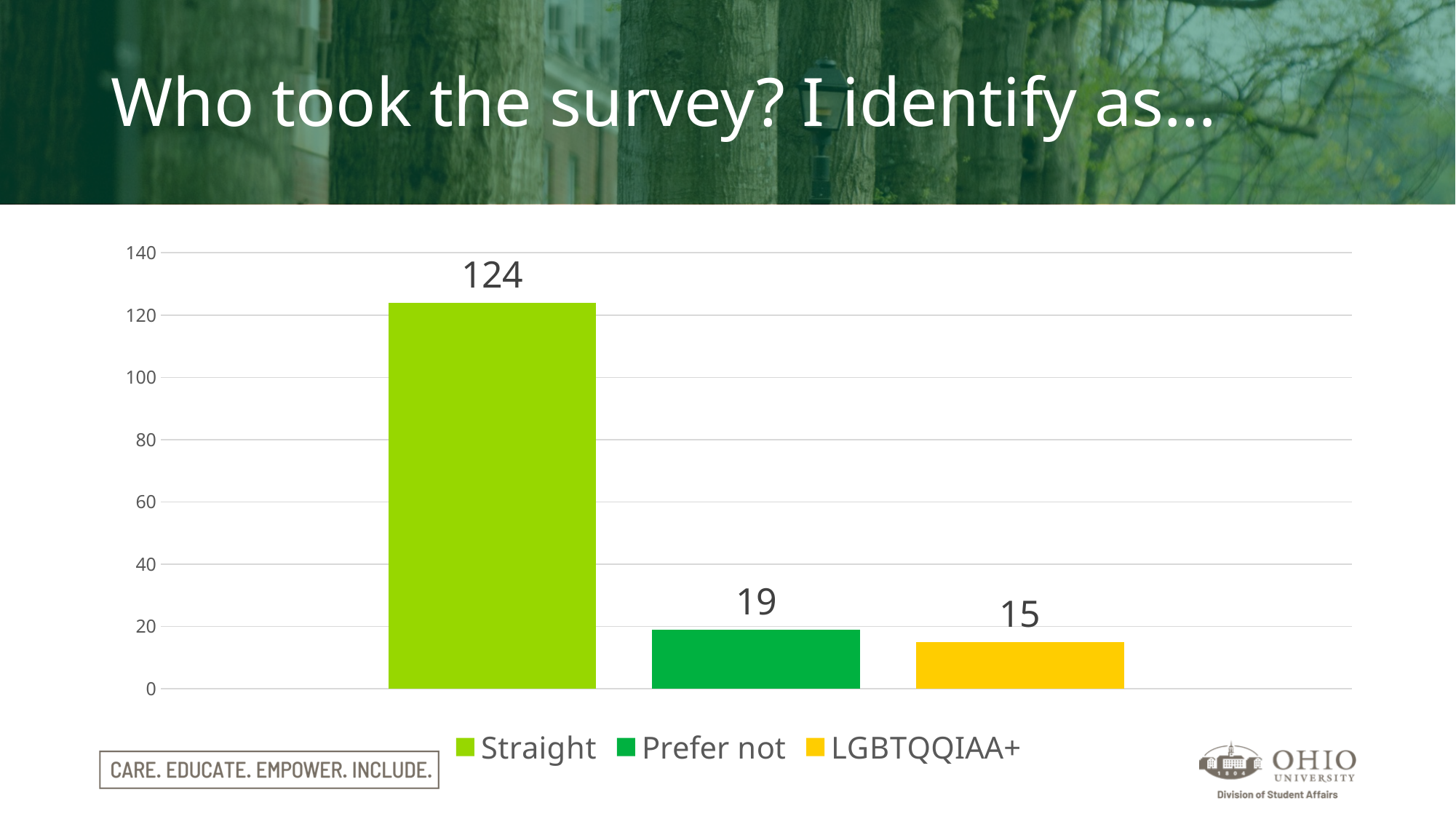
What is the difference between the values for Prefer not and LGBTQQIAA+? 4 Which is larger, the value for Straight or the value for LGBTQQIAA+? Straight What is the value for Prefer not? 19 What kind of chart is shown on the slide? bar chart Which category has the highest value? Straight Is the value for Straight greater or less than 100? greater How many categories are shown in the chart? 3 What is the value for LGBTQQIAA+? 15 What is the value for Straight? 124 What is the title of the slide containing the chart? Who took the survey? I identify as... What is the difference between the values for Straight and Prefer not? 105 Which category has the lowest value? LGBTQQIAA+